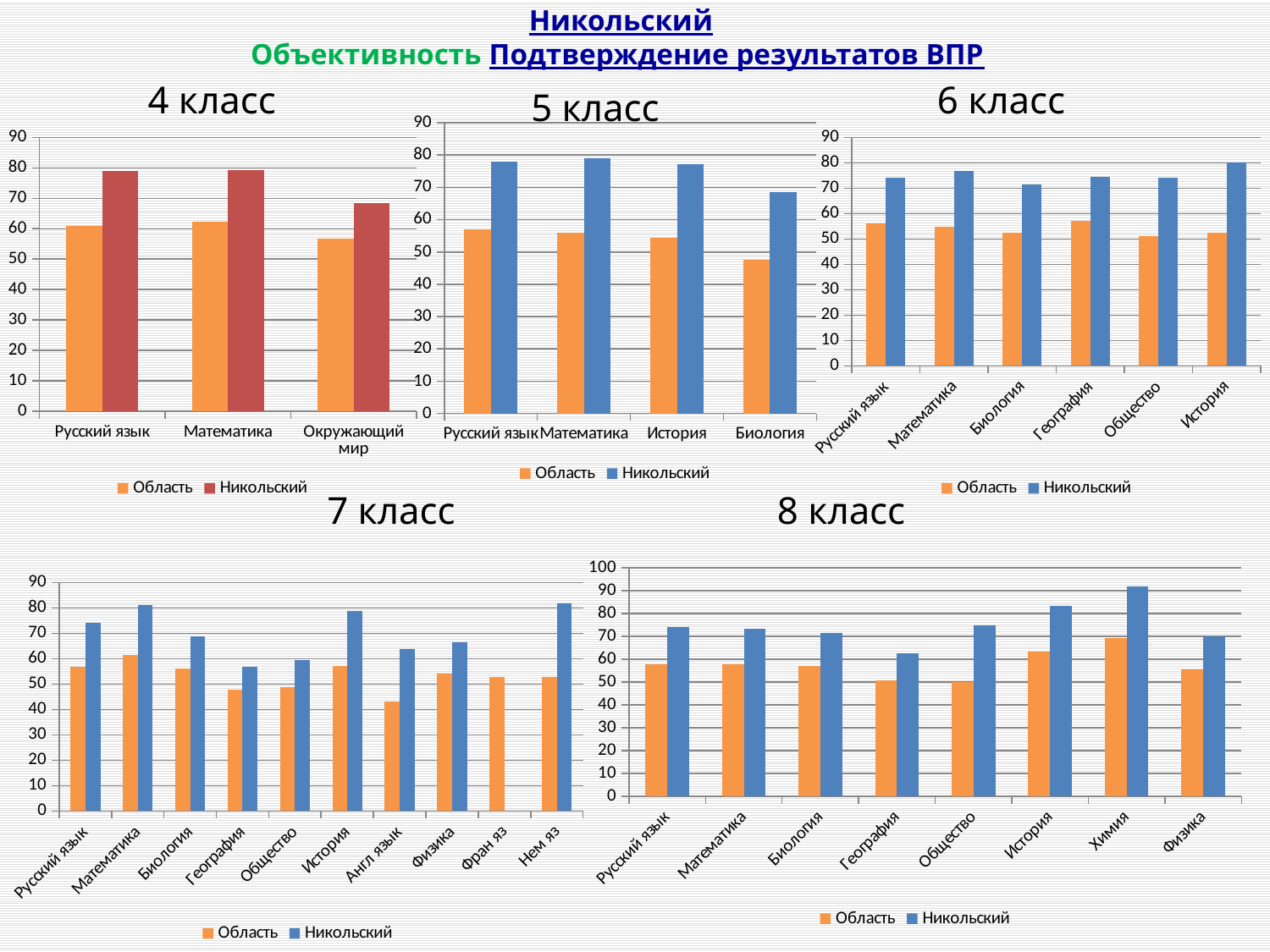
On the 8 класс chart, is the value for Химия in the Никольский series greater or less than 80? greater On the 5 класс chart, which category has the lowest value for Область? Биология On the 4 класс chart, which is larger for Русский язык: Область or Никольский? Никольский On the 7 класс chart, which category has the lowest value for Область? Англ язык On the 6 класс chart, which category has the highest value for Никольский? История On the 4 класс chart, which category has the lowest value for Никольский? Окружающий мир On the 5 класс chart, is the value for Биология in the Область series greater or less than 50? less On the 6 класс chart, how many series does the legend list? 2 On the 4 класс chart, how many categories are shown on the x axis? 3 What kind of chart is the 8 класс chart? bar chart On the 8 класс chart, which category has the highest value for Никольский? Химия On the 7 класс chart, how many categories are shown on the x axis? 10